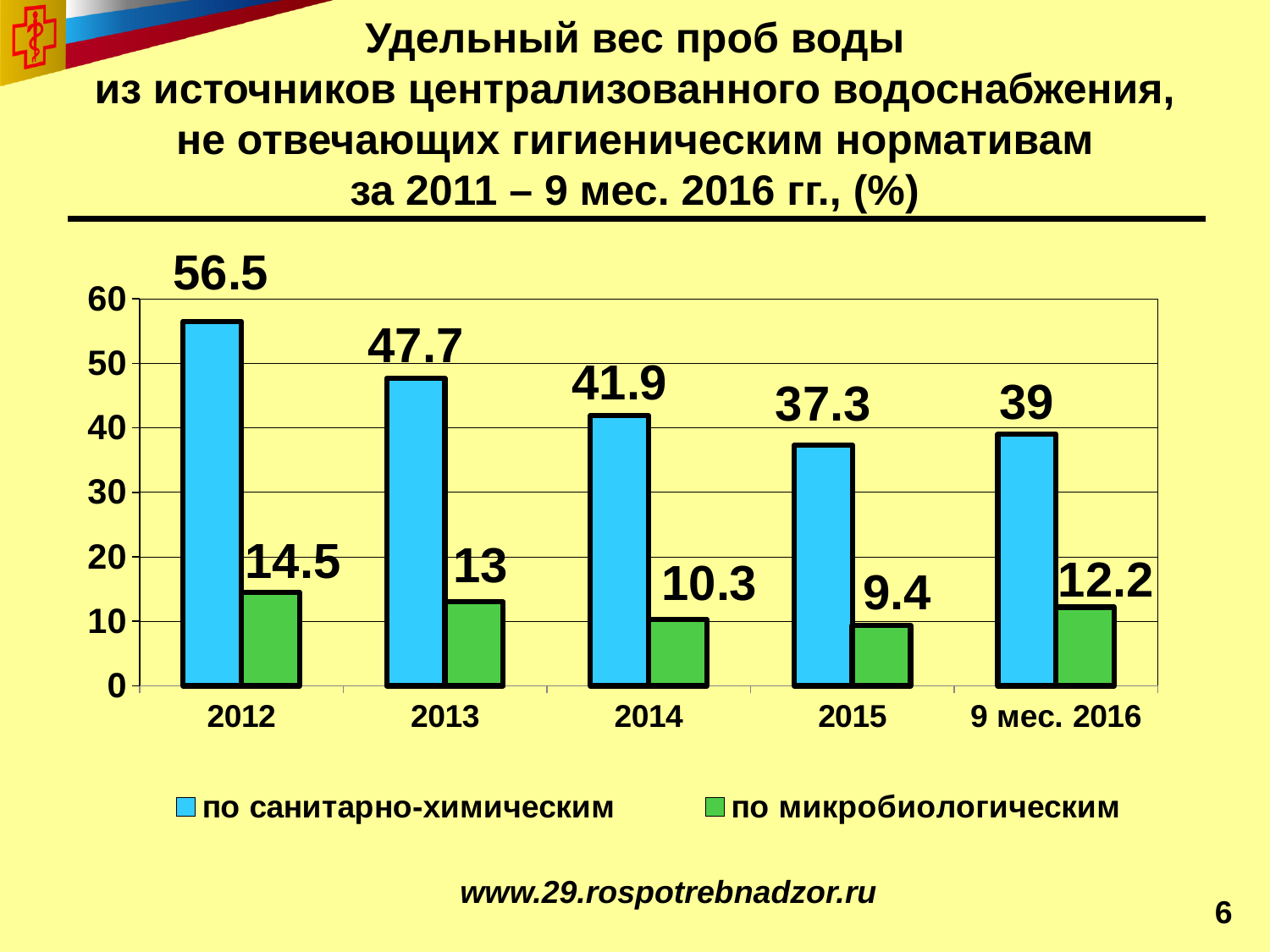
Which is larger: the "по микробиологическим" value for 2013 or for "9 мес. 2016"? 2013 How many series does the legend list? 2 Which category has the lowest value for "по микробиологическим"? 2015 What colour are the bars for "по микробиологическим"? green What kind of chart is shown on the slide? bar chart What is the value for "по микробиологическим" in 2015? 9.4 Does the "по санитарно-химическим" series rise or fall from 2012 to 2015? fall What is the difference between the "по санитарно-химическим" values for 2012 and 2013? 8.8 Which year has the highest value for "по санитарно-химическим"? 2012 What is the value for "по санитарно-химическим" in 2012? 56.5 How many categories are shown on the x axis? 5 What is the value for "по санитарно-химическим" in "9 мес. 2016"? 39